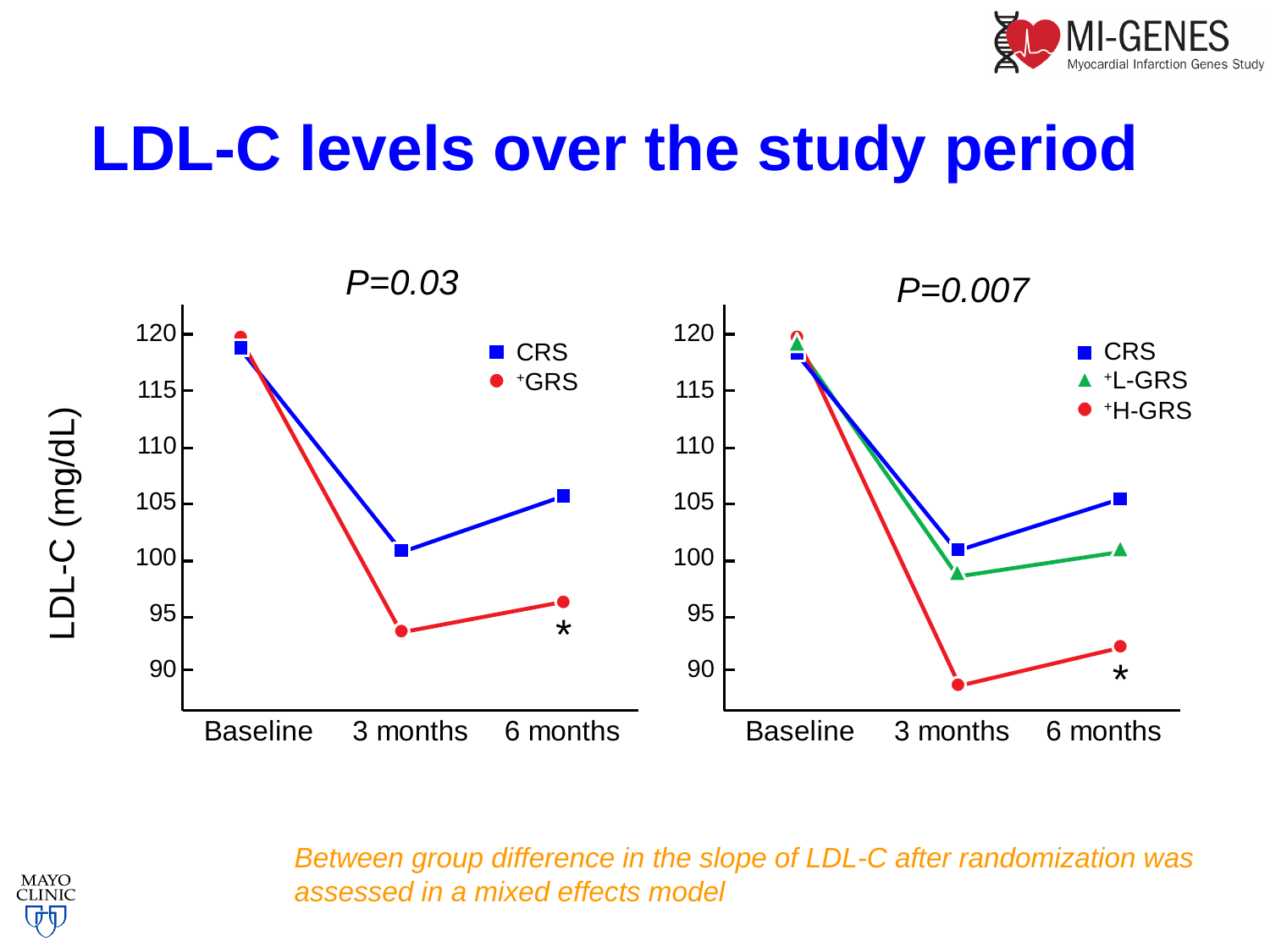
What is the y-axis label shared by the two charts? LDL-C (mg/dL) In the right chart (P=0.007), which series has the lowest value at 6 months? +H-GRS In the right chart (P=0.007), which series has the larger value at 3 months, +L-GRS or +H-GRS? +L-GRS How many series does the legend of the left chart (P=0.03) list? 2 How many time points are shown on the x axis of the left chart (P=0.03)? 3 How many series does the legend of the right chart (P=0.007) list? 3 In the left chart (P=0.03), which series has the larger value at 6 months, CRS or +GRS? CRS In the left chart (P=0.03), is the value for +GRS at 3 months greater or less than 95? less In the right chart (P=0.007), is the value for CRS at 6 months greater or less than 100? greater In the right chart (P=0.007), is the value for +H-GRS at 3 months greater or less than 90? less What kind of chart is the left chart (P=0.03)? line chart In the left chart (P=0.03), do the LDL-C values for CRS rise or fall from Baseline to 3 months? fall